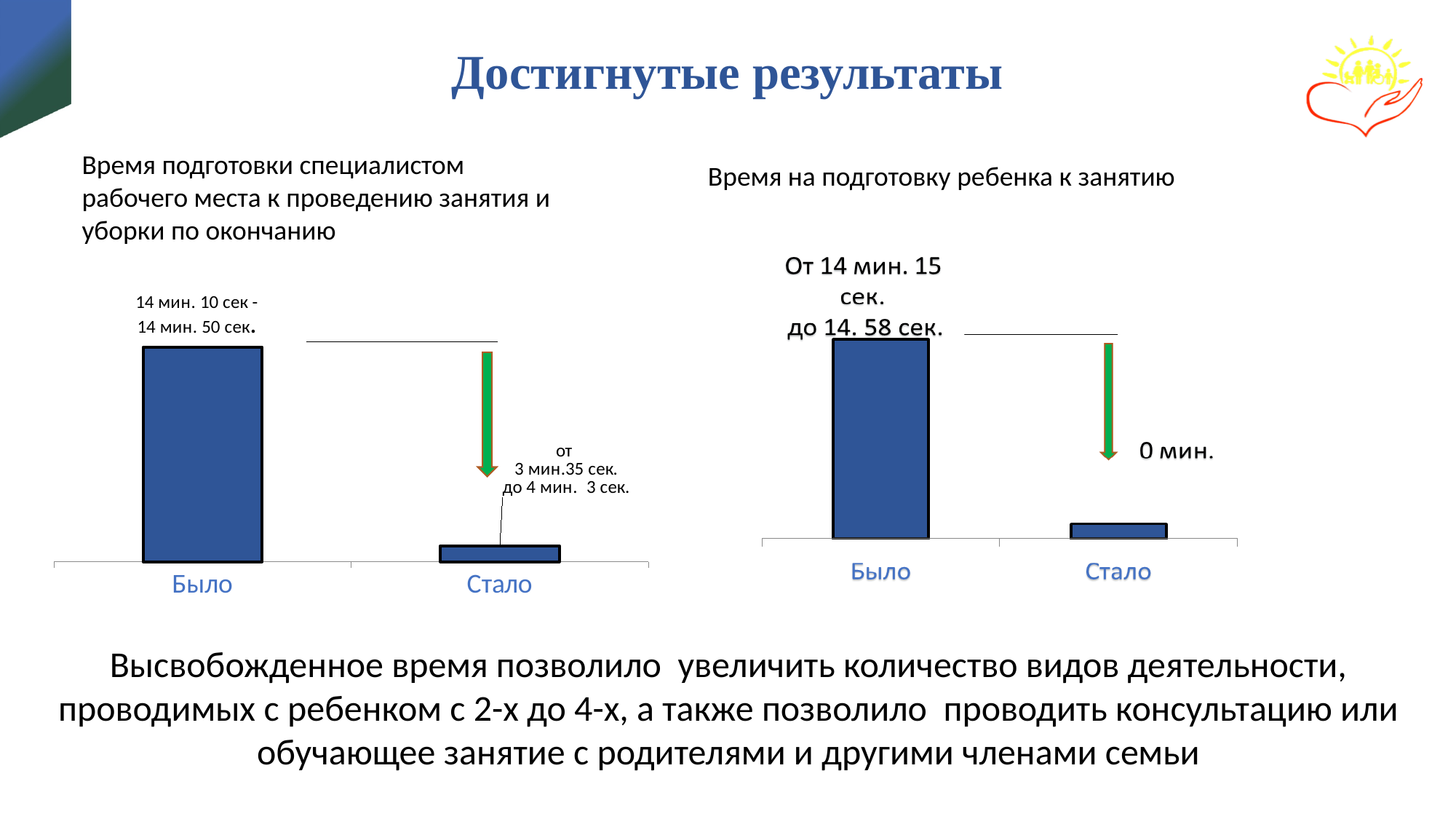
In the right chart (Время на подготовку ребенка к занятию), what is the label shown for the 'Было' bar? От 14 мин. 15 сек. до 14. 58 сек. In the left chart (Время подготовки специалистом рабочего места), what is the label shown for the 'Стало' bar? от 3 мин.35 сек. до 4 мин. 3 сек. What colour are the bars in the left chart (Время подготовки специалистом рабочего места)? Blue What kind of chart is the left chart (Время подготовки специалистом рабочего места)? Bar chart In the right chart (Время на подготовку ребенка к занятию), which category has the shorter bar? Стало In the left chart (Время подготовки специалистом рабочего места), what is the label shown for the 'Было' bar? 14 мин. 10 сек - 14 мин. 50 сек. In the right chart (Время на подготовку ребенка к занятию), what is the label shown for the 'Стало' bar? 0 мин. What is the title of the chart on the right side of the slide? Время на подготовку ребенка к занятию In the right chart (Время на подготовку ребенка к занятию), do the values rise or fall from 'Было' to 'Стало'? Fall How many categories are shown on the x axis of the right chart (Время на подготовку ребенка к занятию)? 2 In the left chart (Время подготовки специалистом рабочего места), which category has the taller bar? Было In the left chart (Время подготовки специалистом рабочего места), is the bar for 'Было' or 'Стало' larger? Было